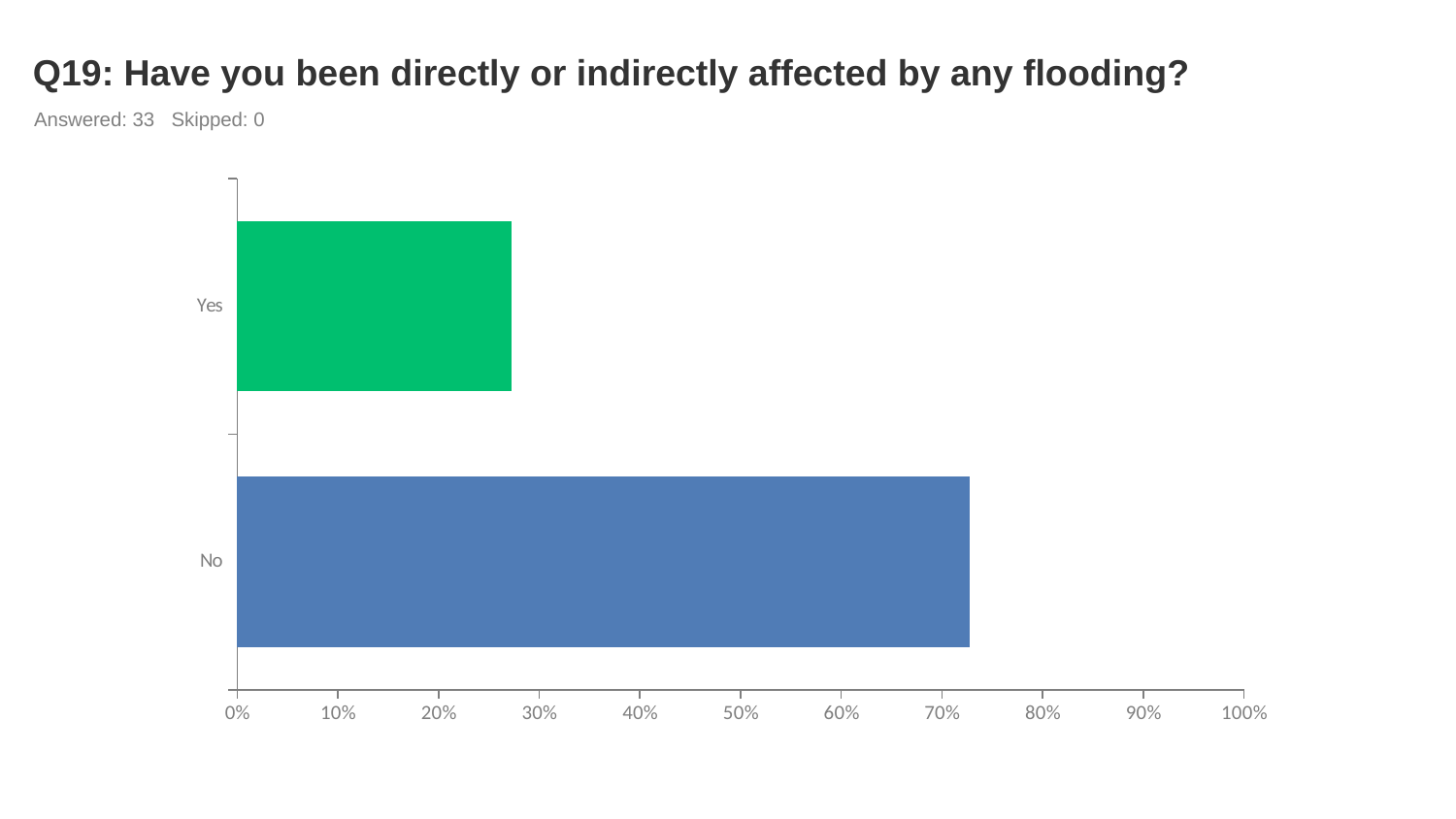
Is the value for Yes greater or less than 30%? less Which is larger, the value for Yes or the value for No? No What is the title of the chart? Q19: Have you been directly or indirectly affected by any flooding? Which category has the highest value? No How many respondents answered the question according to the slide? 33 What kind of chart is shown on the slide? bar chart Is the value for No greater or less than 70%? greater What is the maximum value shown on the x axis? 100% How many categories does the chart show? 2 Is the value for No greater or less than 80%? less Which category has the lowest value? Yes